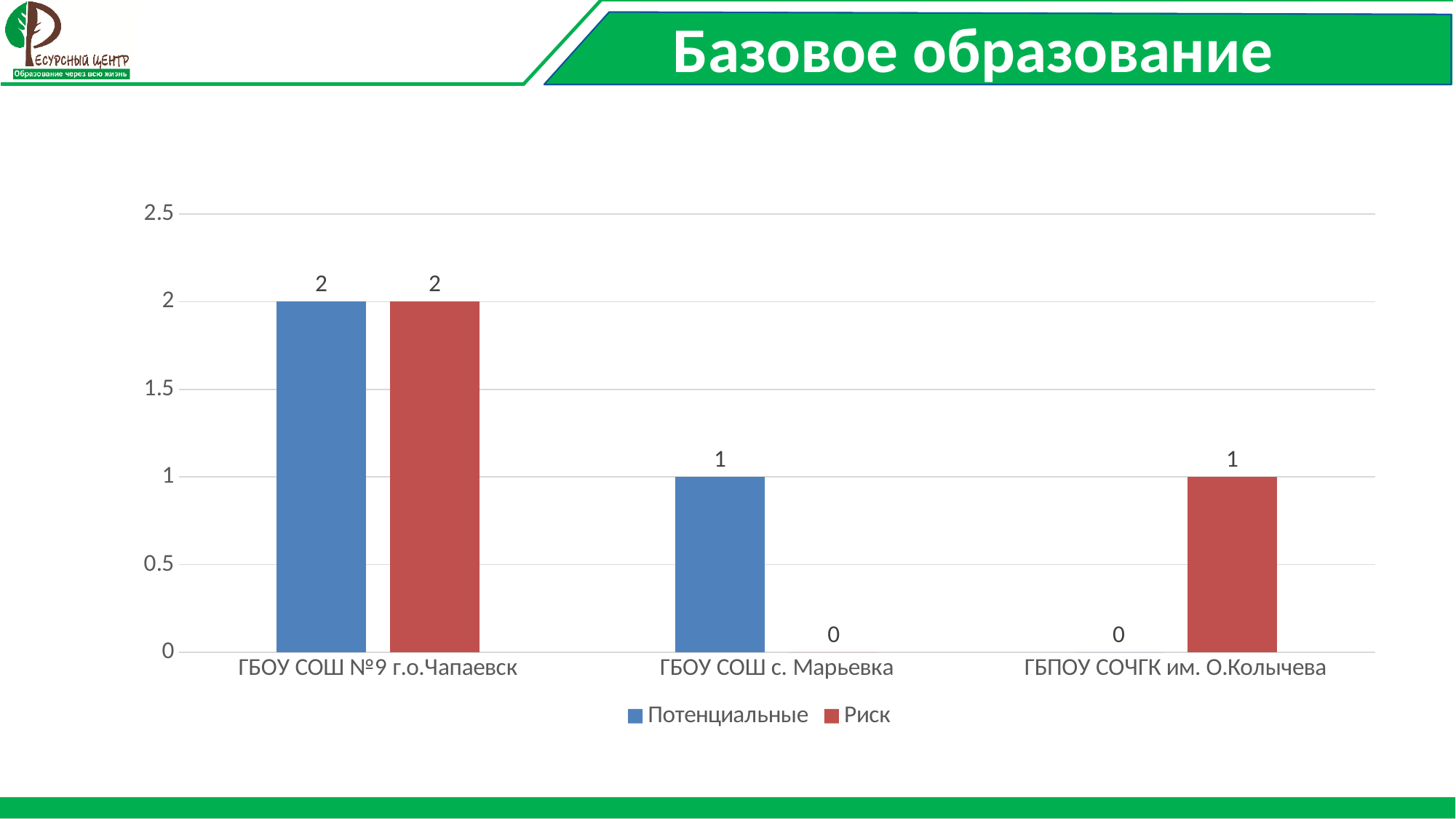
What is the difference between the Потенциальные values for ГБОУ СОШ №9 г.о.Чапаевск and ГБОУ СОШ с. Марьевка? 1 What is the value of Потенциальные for ГБПОУ СОЧГК им. О.Колычева? 0 Which category has the highest Потенциальные value? ГБОУ СОШ №9 г.о.Чапаевск How many categories are shown on the x axis? 3 What is the value of Риск for ГБПОУ СОЧГК им. О.Колычева? 1 What kind of chart is shown on the slide? Bar chart How many series does the legend list? 2 Which is larger for ГБОУ СОШ с. Марьевка: Потенциальные or Риск? Потенциальные What colour represents the Риск series? Red What is the value of Потенциальные for ГБОУ СОШ №9 г.о.Чапаевск? 2 Which category has the lowest Риск value? ГБОУ СОШ с. Марьевка What is the value of Риск for ГБОУ СОШ с. Марьевка? 0